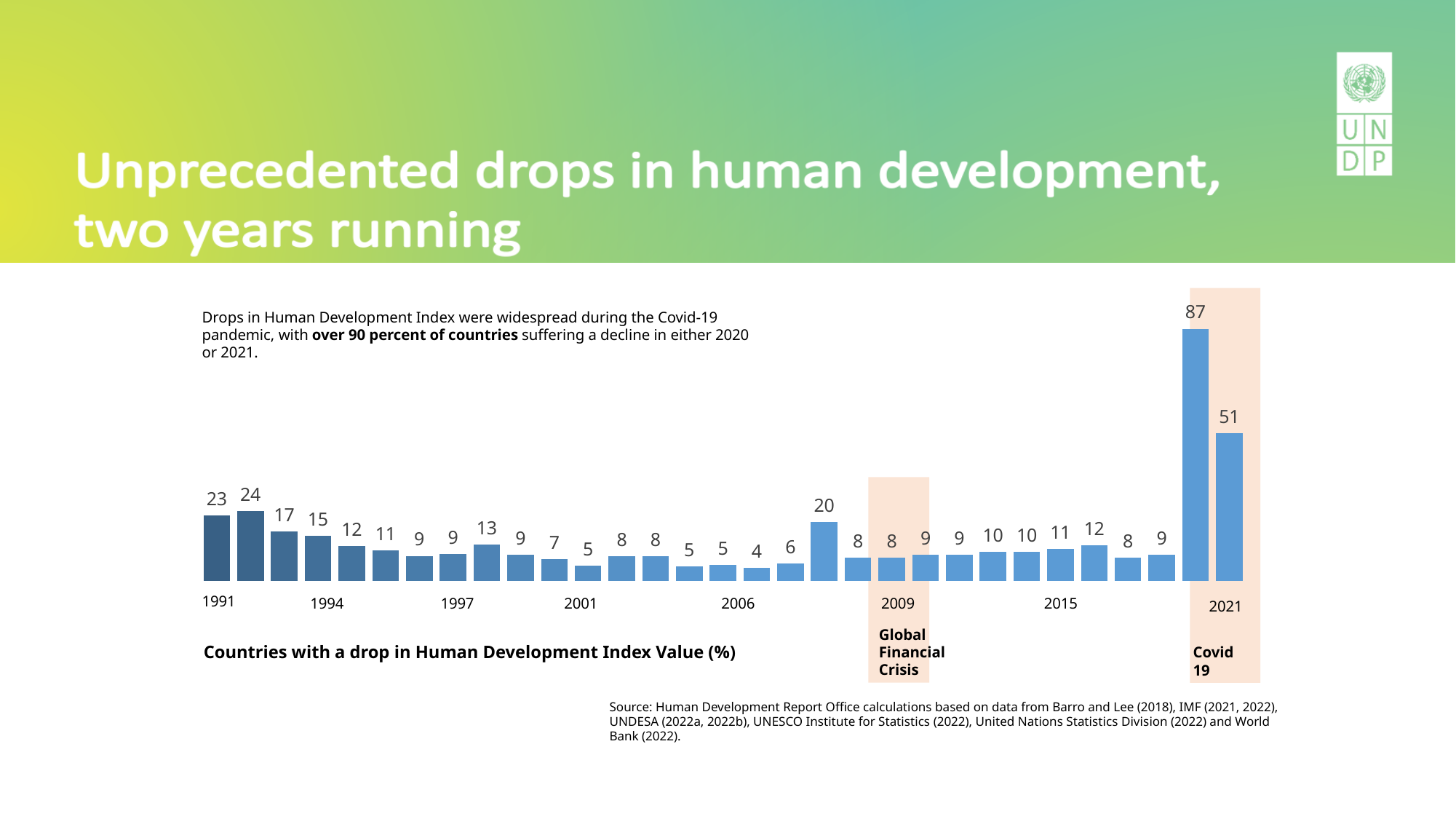
What is the value for 2020, the first bar in the Covid 19 highlighted area? 87 What is the title of the chart? Countries with a drop in Human Development Index Value (%) What is the value for 2021? 51 How many bars are plotted in the chart? 31 What is the difference between the two bars in the Covid 19 highlighted area (87 and 51)? 36 Which is larger, the value for 2020 or the value for 2021? 2020 What two events are labelled with shaded highlight areas on the chart? Global Financial Crisis and Covid 19 What is the highest value shown in the chart? 87 What is the lowest value shown in the chart? 4 Do the values generally rise or fall across the first six bars starting from 1991? Fall What type of chart is shown on the slide? Bar chart What is the value for 1991? 23